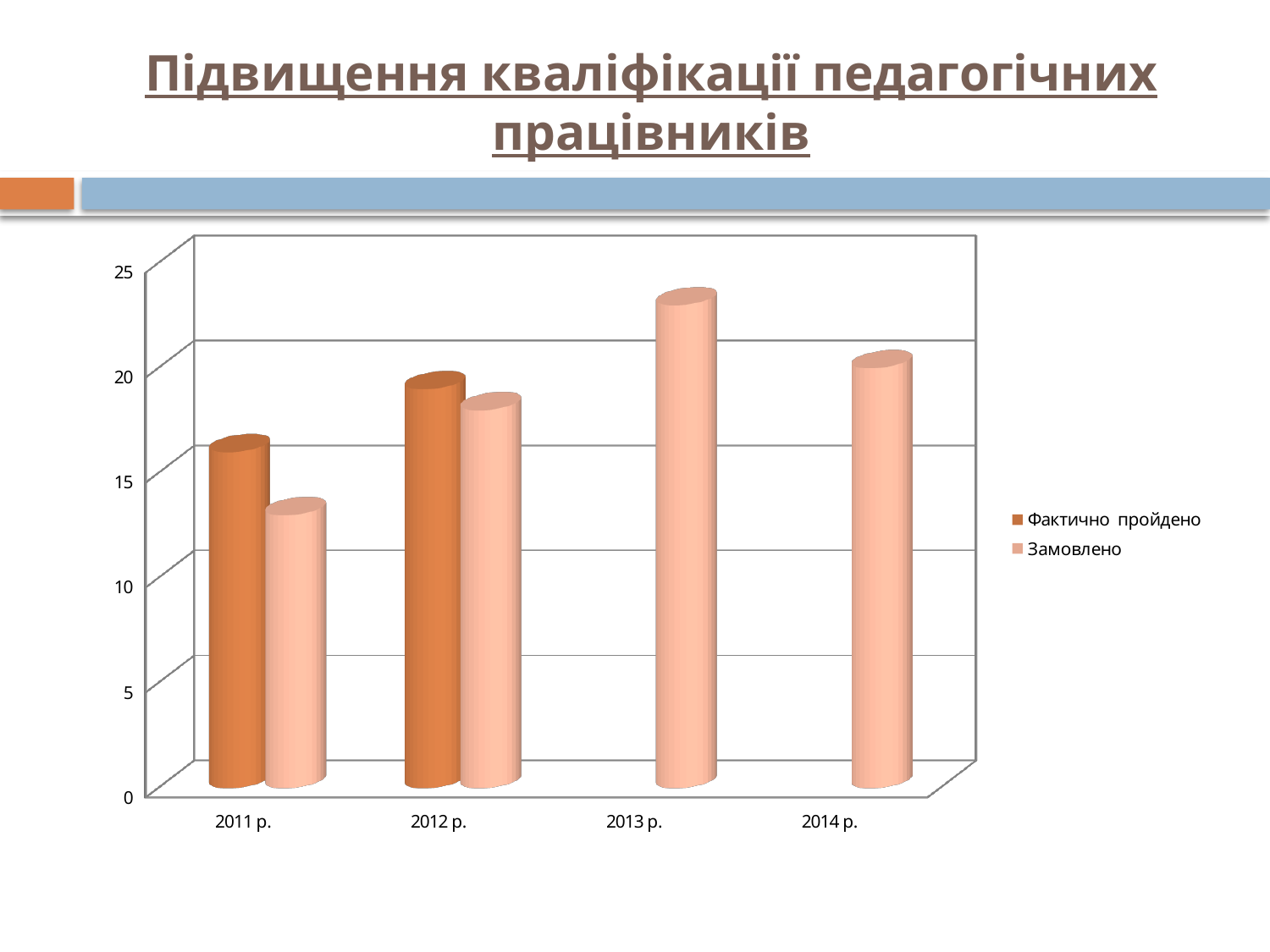
Does the value for Замовлено rise or fall from 2011 р. to 2013 р.? rise How many series does the legend list? 2 Is the value for Замовлено in 2014 р. greater or less than 15? greater Which year has the highest value for Замовлено? 2013 р. In 2011 р., which is larger: Фактично пройдено or Замовлено? Фактично пройдено Is the value for Фактично пройдено in 2011 р. greater or less than 20? less What are the two series named in the legend? Фактично пройдено and Замовлено How many year categories are shown on the x axis? 4 Is the value for Замовлено in 2011 р. greater or less than 15? less Which year has the lowest value for Замовлено? 2011 р. What kind of chart is shown on the slide? bar chart